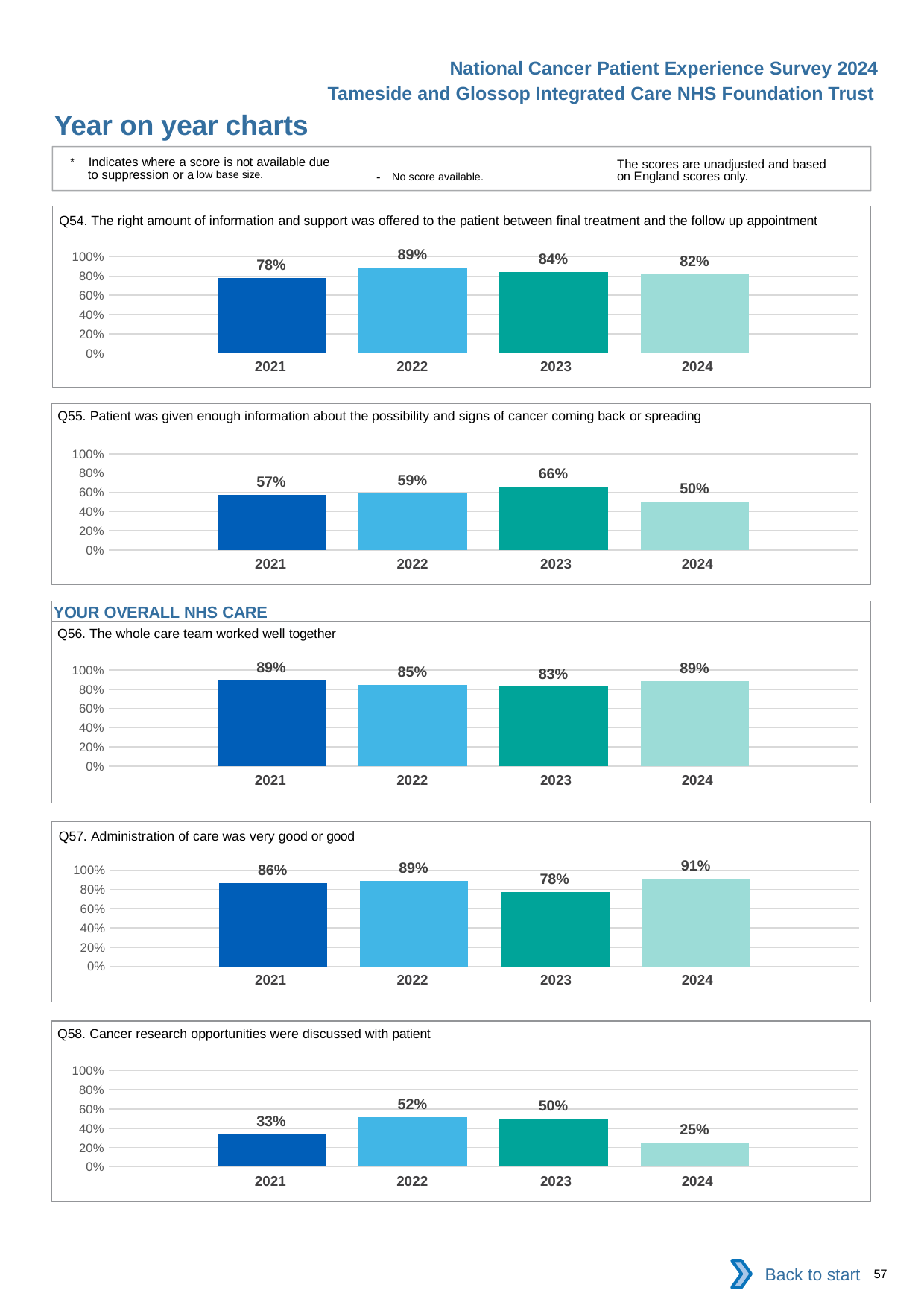
What kind of chart is the Q56 chart? bar chart In the Q58 chart, what is the value for 2024? 25% In the Q58 chart, what is the difference between the 2022 and 2021 values? 19% In the Q54 chart, what is the value for 2022? 89% How many years are shown in the Q54 chart? 4 In the Q57 chart, which year has the highest value? 2024 In the Q55 chart, which year has the lowest value? 2024 In the Q58 chart, is the value for 2021 greater or less than 40%? less In the Q57 chart, is the value for 2023 larger or smaller than the value for 2022? smaller In the Q55 chart, what is the difference between the 2023 and 2024 values? 16% In the Q56 chart, what is the value for 2023? 83% In the Q54 chart, do the values rise or fall from 2022 to 2024? fall